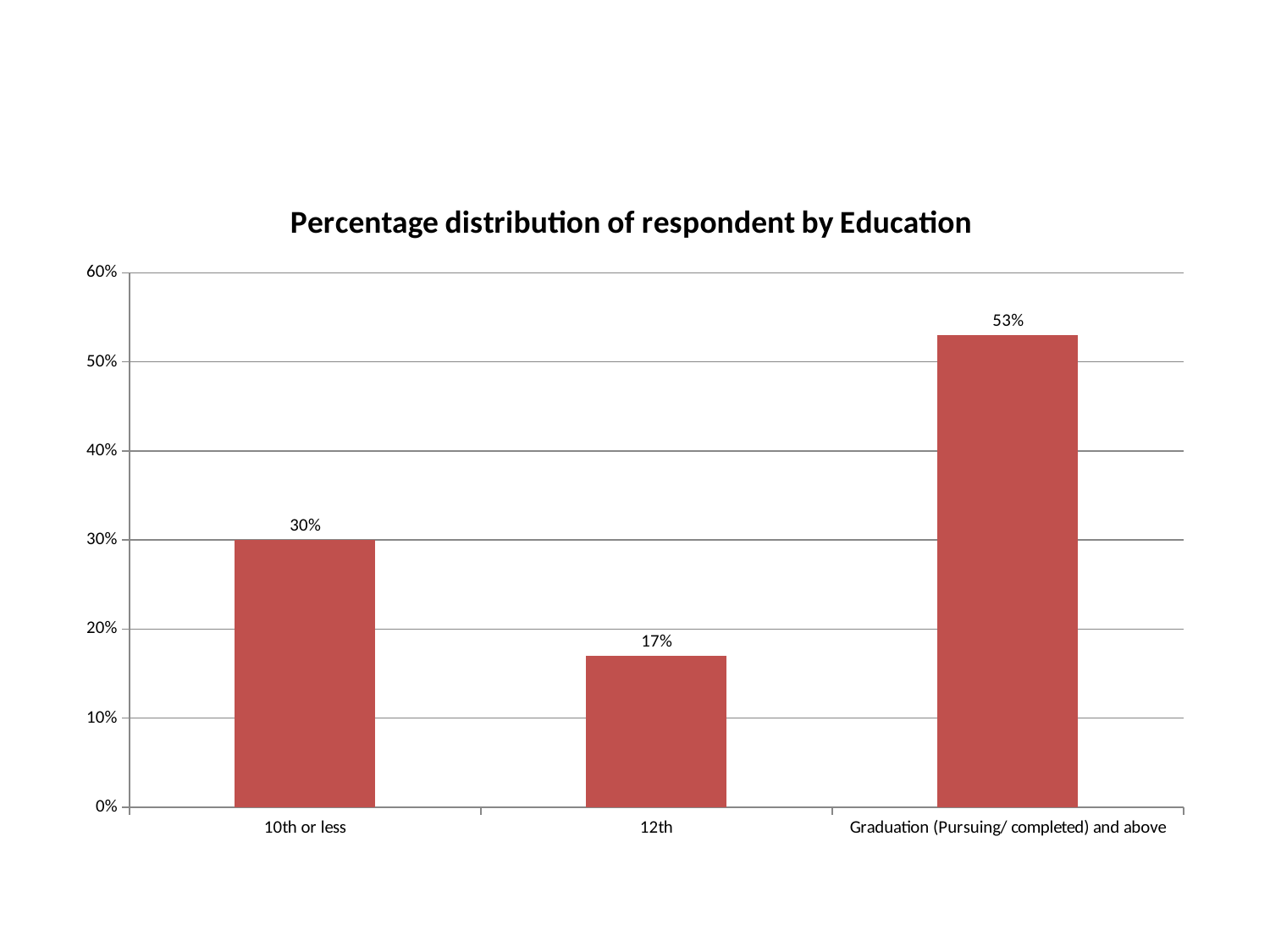
What is the difference between the values for 10th or less and 12th? 13% What kind of chart is shown on the slide? bar chart What is the value for Graduation (Pursuing/ completed) and above? 53% Which is larger, the value for 10th or less or the value for 12th? 10th or less Which education category has the highest percentage? Graduation (Pursuing/ completed) and above What is the value for 12th? 17% How many education categories are shown in the chart? 3 Which education category has the lowest percentage? 12th What is the value for 10th or less? 30% What is the title of the chart? Percentage distribution of respondent by Education Is the value for Graduation (Pursuing/ completed) and above greater or less than 50%? greater What is the difference between the values for Graduation (Pursuing/ completed) and above and 10th or less? 23%